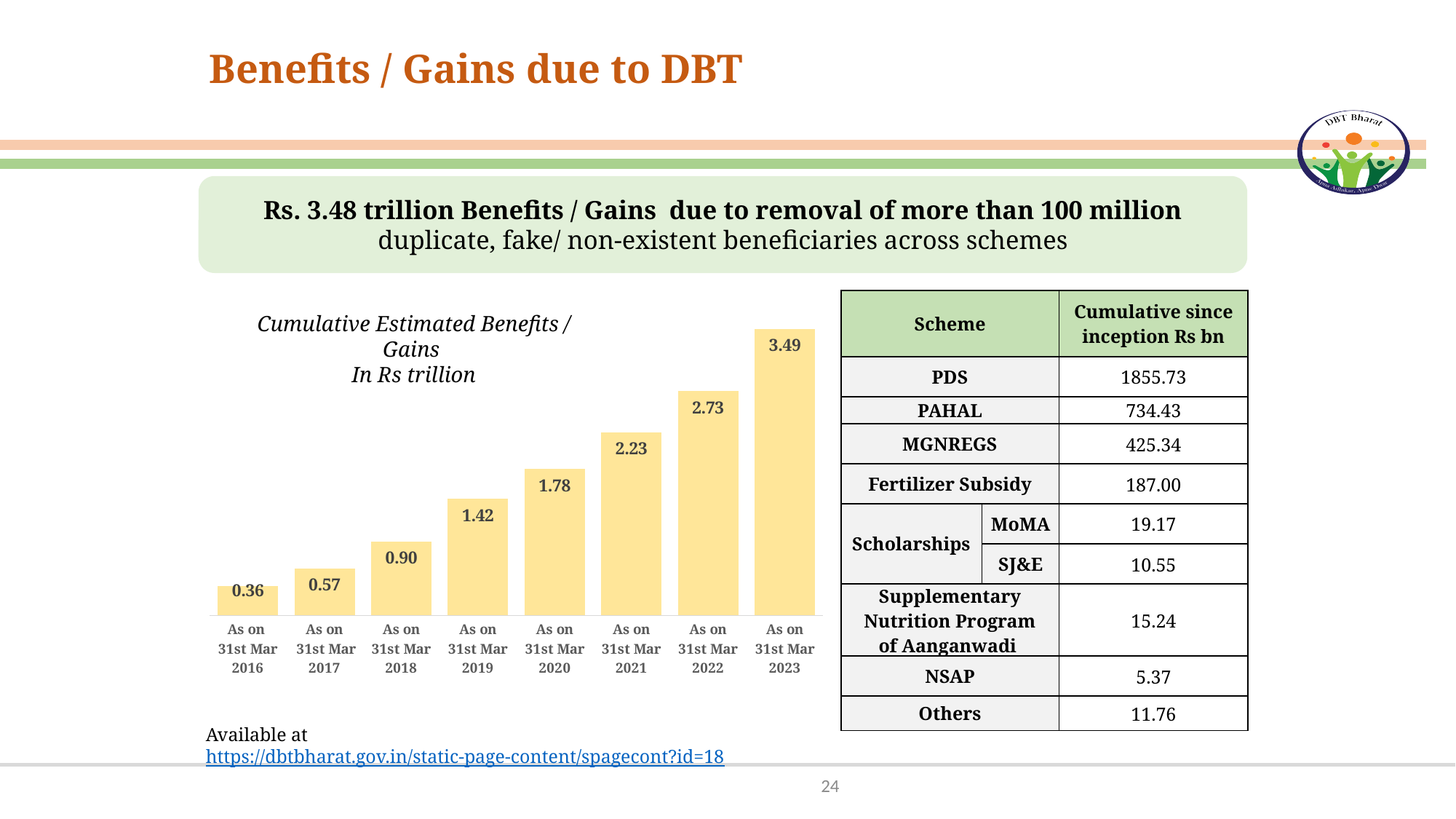
Do the values rise or fall from 2016 to 2023? Rise What is the difference between the values for 31st Mar 2023 and 31st Mar 2022? 0.76 Which is larger, the value for 31st Mar 2021 or 31st Mar 2020? 31st Mar 2021 What is the cumulative estimated benefit as on 31st Mar 2016? 0.36 Which year has the lowest cumulative estimated benefit? As on 31st Mar 2016 What is the cumulative estimated benefit as on 31st Mar 2019? 1.42 What kind of chart is shown on the slide? Bar chart What is the difference between the values for 31st Mar 2020 and 31st Mar 2018? 0.88 What is the cumulative estimated benefit as on 31st Mar 2023? 3.49 In what unit are the chart values expressed? Rs trillion How many bars are shown in the chart? 8 Which year has the highest cumulative estimated benefit? As on 31st Mar 2023